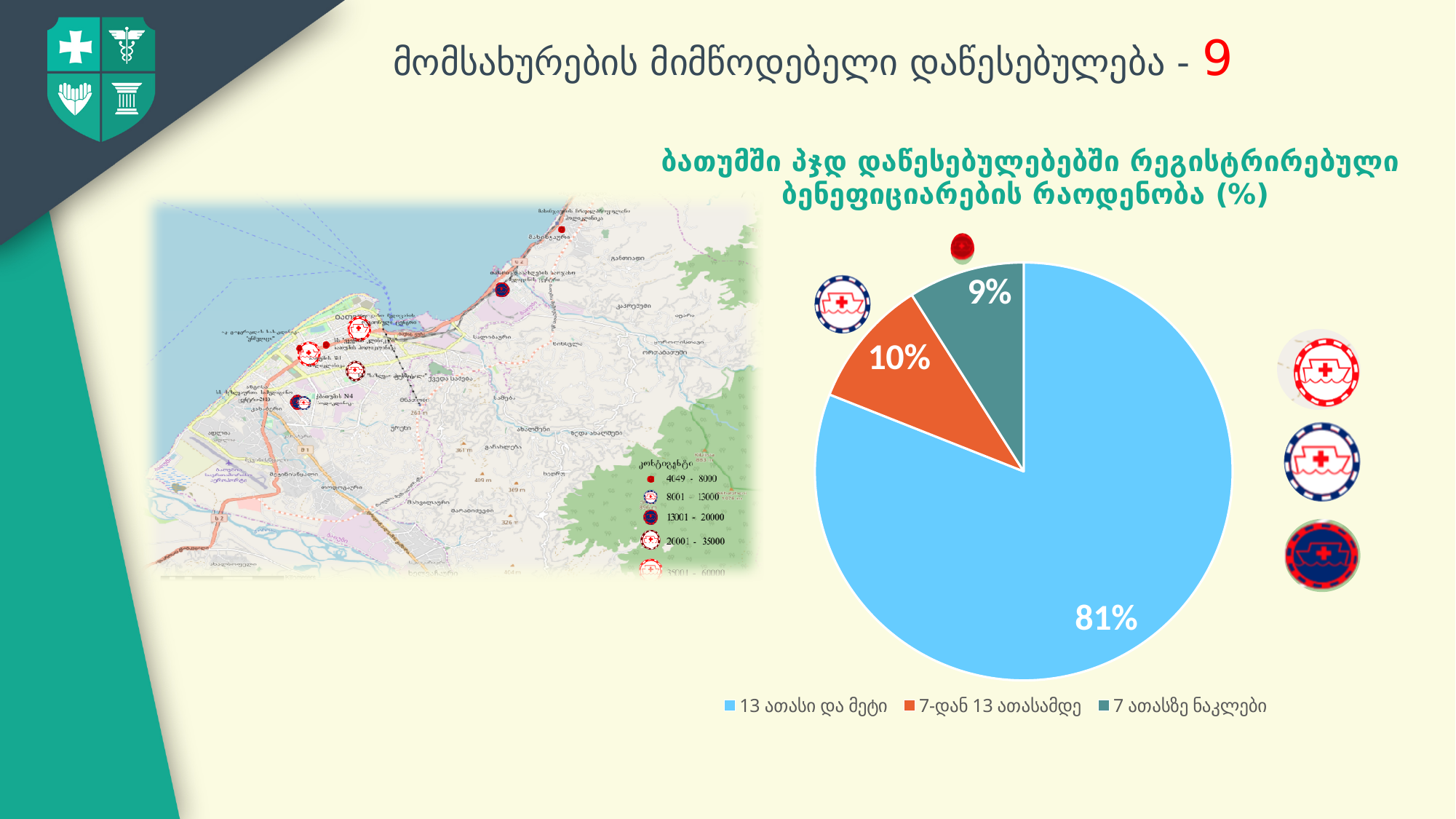
How many entries does the pie chart's legend list? 3 In the pie chart, what share is shown for the category "7 ათასზე ნაკლები"? 9% What is the difference in percentage points between the "13 ათასი და მეტი" slice and the "7-დან 13 ათასამდე" slice? 71 How many slices does the pie chart have? 3 What colour is the slice labelled 81% in the pie chart? Light blue Which category has the smallest slice in the pie chart? 7 ათასზე ნაკლები Which category has the largest slice in the pie chart? 13 ათასი და მეტი Which slice is larger in the pie chart: "7-დან 13 ათასამდე" or "7 ათასზე ნაკლები"? 7-დან 13 ათასამდე What is the title of the pie chart? ბათუმში პჯდ დაწესებულებებში რეგისტრირებული ბენეფიციარების რაოდენობა (%) In the pie chart, what share is shown for the category "13 ათასი და მეტი"? 81% What kind of chart is shown on the right side of the slide? Pie chart In the pie chart, what share is shown for the category "7-დან 13 ათასამდე"? 10%